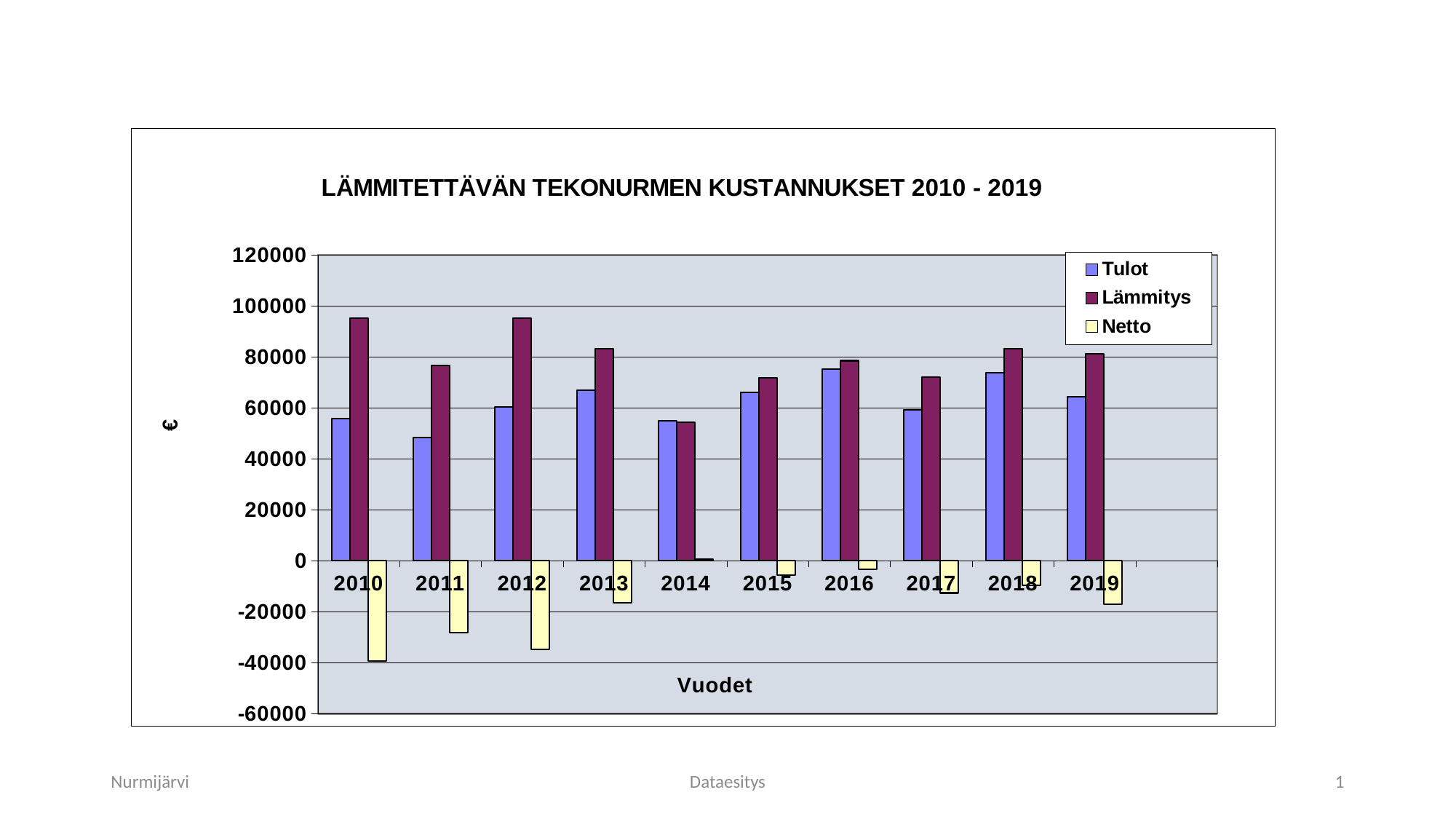
In which year is the Tulot value lowest? 2011 What is the label of the x axis? Vuodet Is the Lämmitys value for 2014 greater or less than 60000? less Is the Netto value for 2011 greater or less than -20000? less What is the title of the chart? LÄMMITETTÄVÄN TEKONURMEN KUSTANNUKSET 2010 - 2019 In 2010, which is larger, Tulot or Lämmitys? Lämmitys Is the Lämmitys value for 2010 greater or less than 80000? greater In which year is the Lämmitys value lowest? 2014 What kind of chart is shown on the slide? bar chart How many years are shown on the x axis? 10 How many series does the legend list? 3